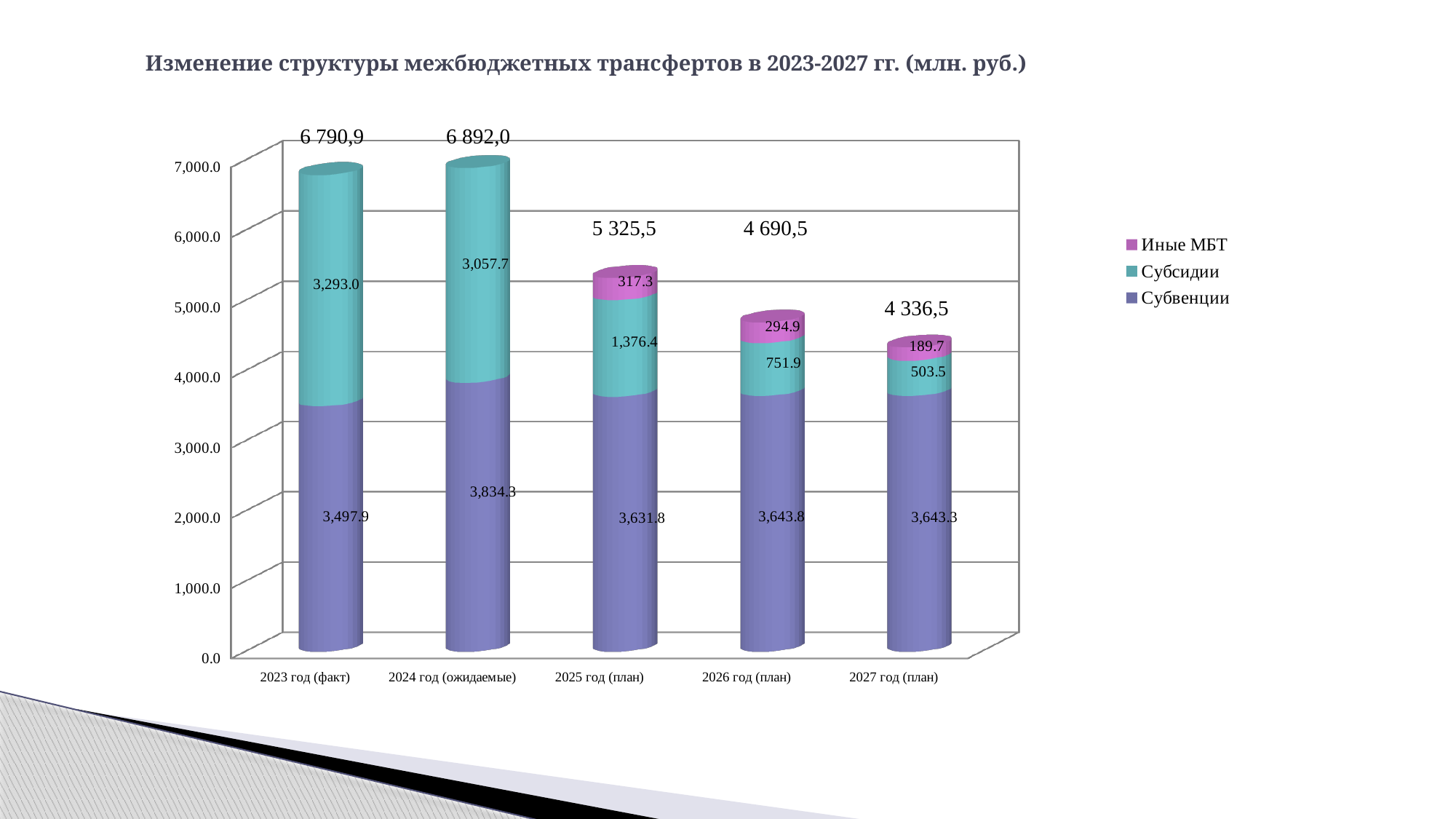
How many series does the legend list? 3 What type of chart is shown on the slide? stacked bar chart Which year has the lowest value of Субсидии? 2027 год (план) Do the Субсидии values rise or fall from 2023 to 2027? fall What is the difference between the Субсидии values for 2023 год (факт) and 2024 год (ожидаемые)? 235.3 Which is larger: Субсидии for 2025 год (план) or Субсидии for 2026 год (план)? 2025 год (план) How many year categories are shown on the x axis? 5 What is the value of Субсидии for 2025 год (план)? 1,376.4 What is the total of the stacked bar for 2027 год (план)? 4 336,5 What is the value of Субвенции for 2024 год (ожидаемые)? 3,834.3 Which year has the highest total of intergovernmental transfers? 2024 год (ожидаемые) What is the value of Иные МБТ for 2026 год (план)? 294.9